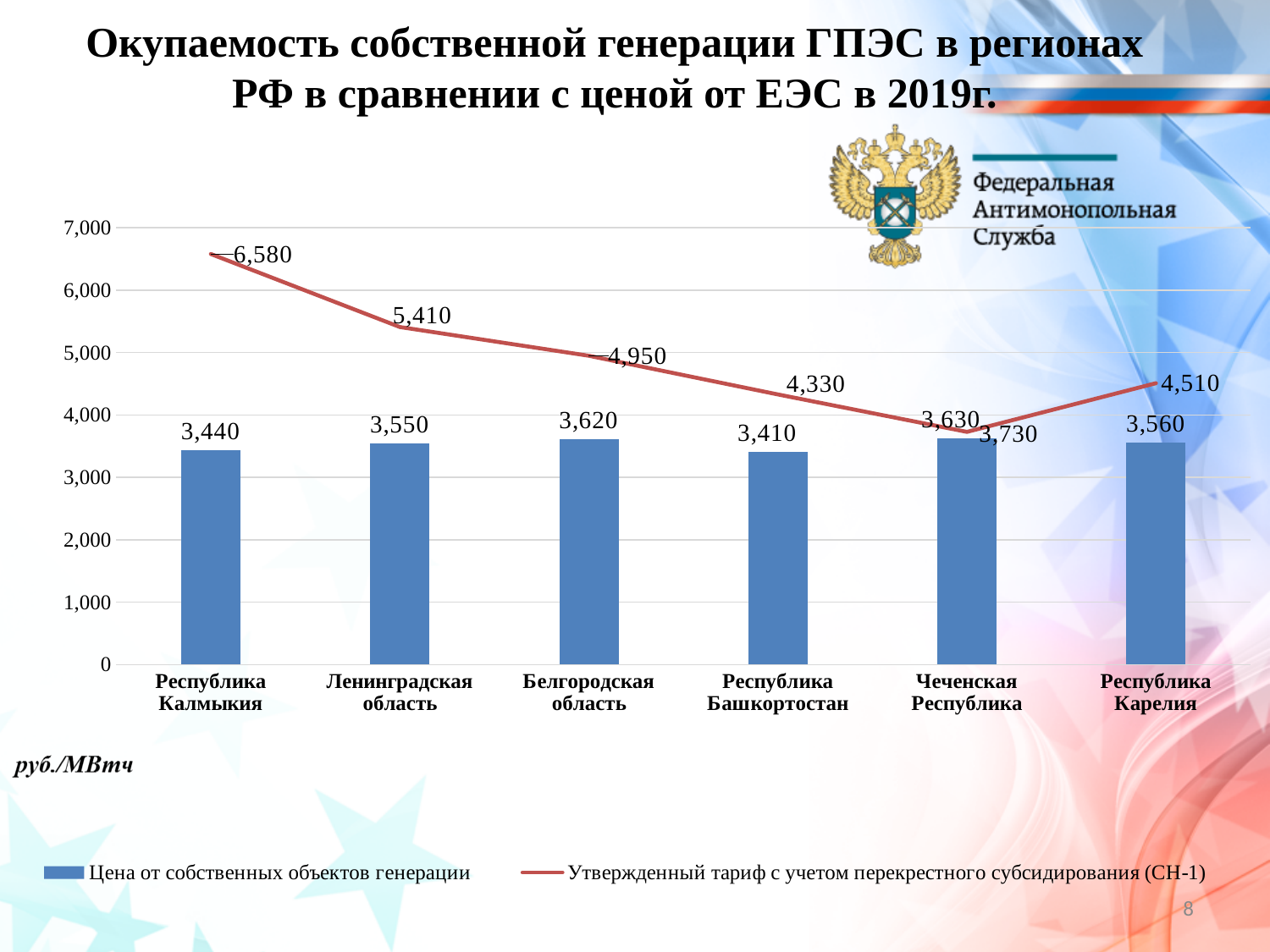
Which region has the lowest value on the line series (Утвержденный тариф)? Чеченская Республика Which region has the highest value on the line series (Утвержденный тариф)? Республика Калмыкия What is the difference between the line value and the bar value for Республика Калмыкия? 3,140 What is the bar value for Республика Башкортостан? 3,410 What is the line value for Республика Карелия? 4,510 What is the difference between the line value and the bar value for Республика Карелия? 950 What is the value of the line (Утвержденный тариф с учетом перекрестного субсидирования (СН-1)) for Ленинградская область? 5,410 What is the value of the bar (Цена от собственных объектов генерации) for Республика Калмыкия? 3,440 What kind of chart is this? a combined bar and line chart How many regions are shown on the x axis? 6 For Белгородская область, which is larger: the bar value or the line value? the line value (4,950) How many series does the legend list? 2